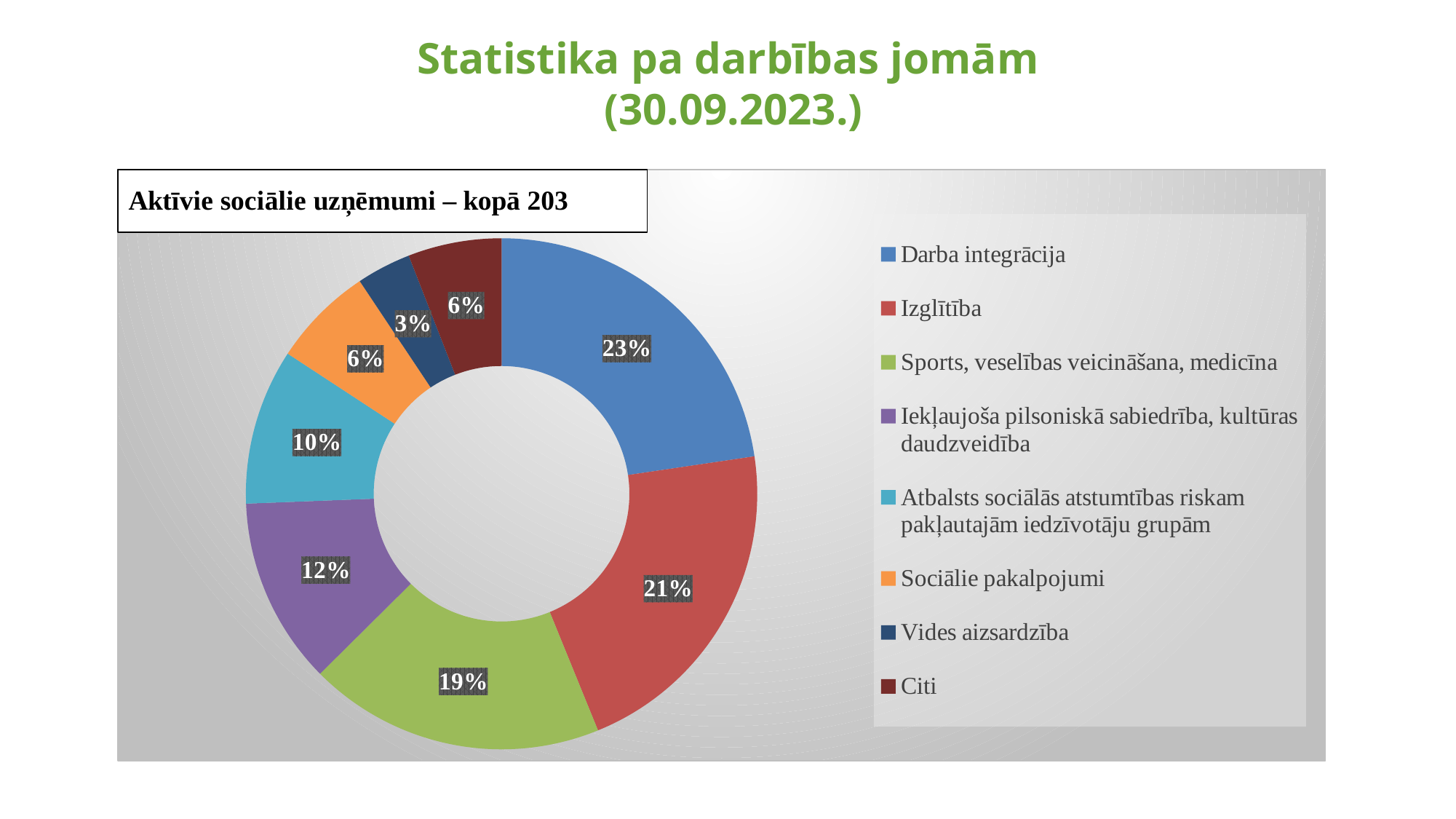
What is the difference in percentage points between Darba integrācija and Izglītība? 2 What share of the chart does Darba integrācija account for? 23% Which category has the smallest share of the chart? Vides aizsardzība Which category has the largest share of the chart? Darba integrācija What is the value for Sports, veselības veicināšana, medicīna? 19% What is the total number of active social enterprises stated in the chart's title box? 203 What percentage is shown for Izglītība? 21% Which is larger: the share for Iekļaujoša pilsoniskā sabiedrība, kultūras daudzveidība or the share for Atbalsts sociālās atstumtības riskam pakļautajām iedzīvotāju grupām? Iekļaujoša pilsoniskā sabiedrība, kultūras daudzveidība What percentage is shown for Vides aizsardzība? 3% What percentage is shown for Citi? 6% What kind of chart is shown on the slide? Pie chart (doughnut) How many categories does the legend list? 8